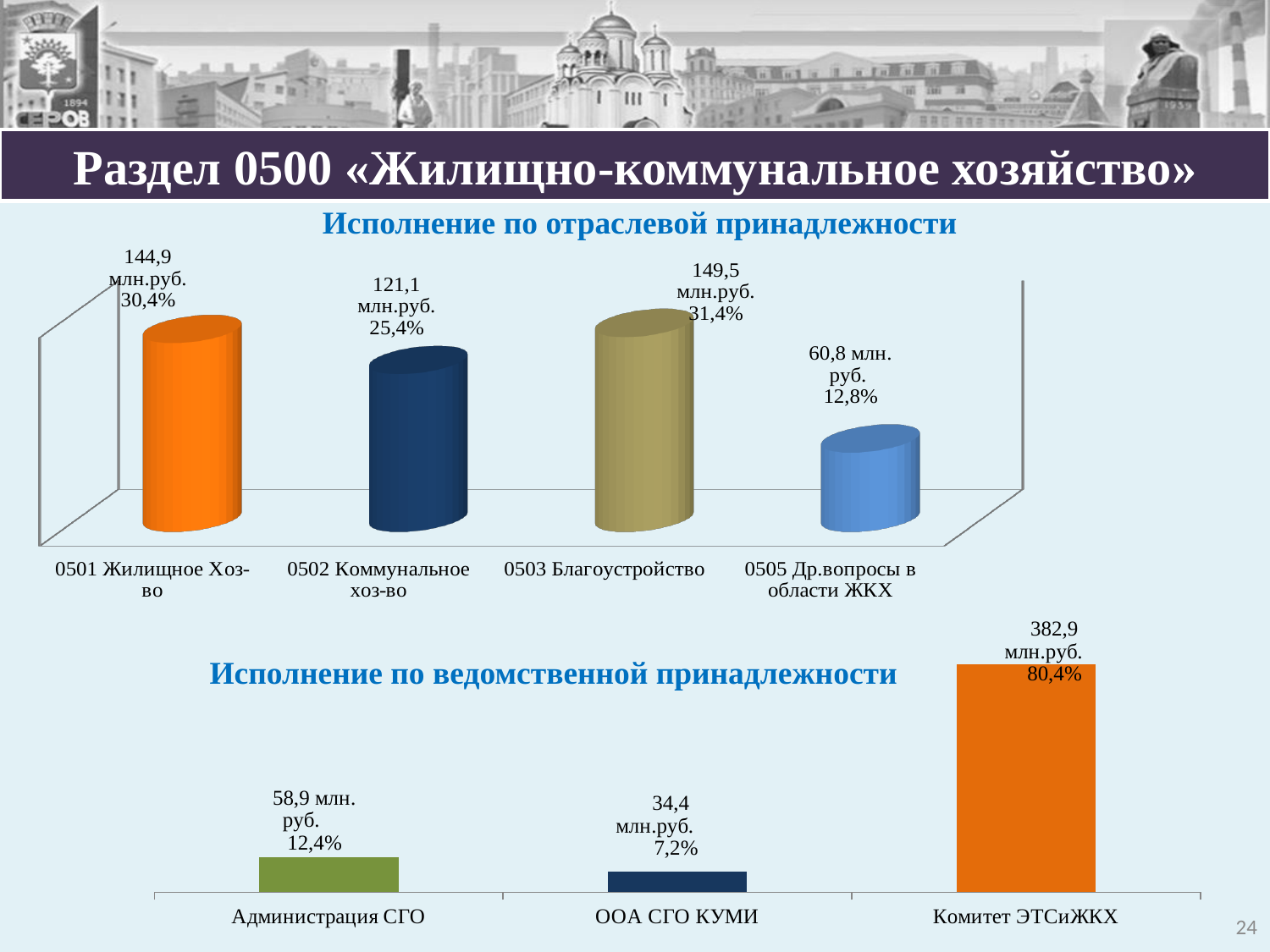
In the chart 'Исполнение по отраслевой принадлежности', what is the difference between 0501 Жилищное Хоз-во and 0505 Др.вопросы в области ЖКХ? 84,1 млн.руб. What type of chart is 'Исполнение по ведомственной принадлежности'? Bar chart In the chart 'Исполнение по ведомственной принадлежности', what is the value for Комитет ЭТСиЖКХ? 382,9 млн.руб. In the chart 'Исполнение по ведомственной принадлежности', what is the difference between Администрация СГО and ООА СГО КУМИ? 24,5 млн.руб. In the chart 'Исполнение по ведомственной принадлежности', which is larger: Администрация СГО or ООА СГО КУМИ? Администрация СГО In the chart 'Исполнение по ведомственной принадлежности', what percentage is shown for ООА СГО КУМИ? 7,2% In the chart 'Исполнение по отраслевой принадлежности', which category has the highest value? 0503 Благоустройство In the chart 'Исполнение по отраслевой принадлежности', what percentage is shown for 0502 Коммунальное хоз-во? 25,4% In the chart 'Исполнение по отраслевой принадлежности', how many categories are shown? 4 In the chart 'Исполнение по отраслевой принадлежности', what is the value for 0503 Благоустройство? 149,5 млн.руб. In the chart 'Исполнение по ведомственной принадлежности', how many categories are shown? 3 In the chart 'Исполнение по отраслевой принадлежности', which category has the lowest value? 0505 Др.вопросы в области ЖКХ